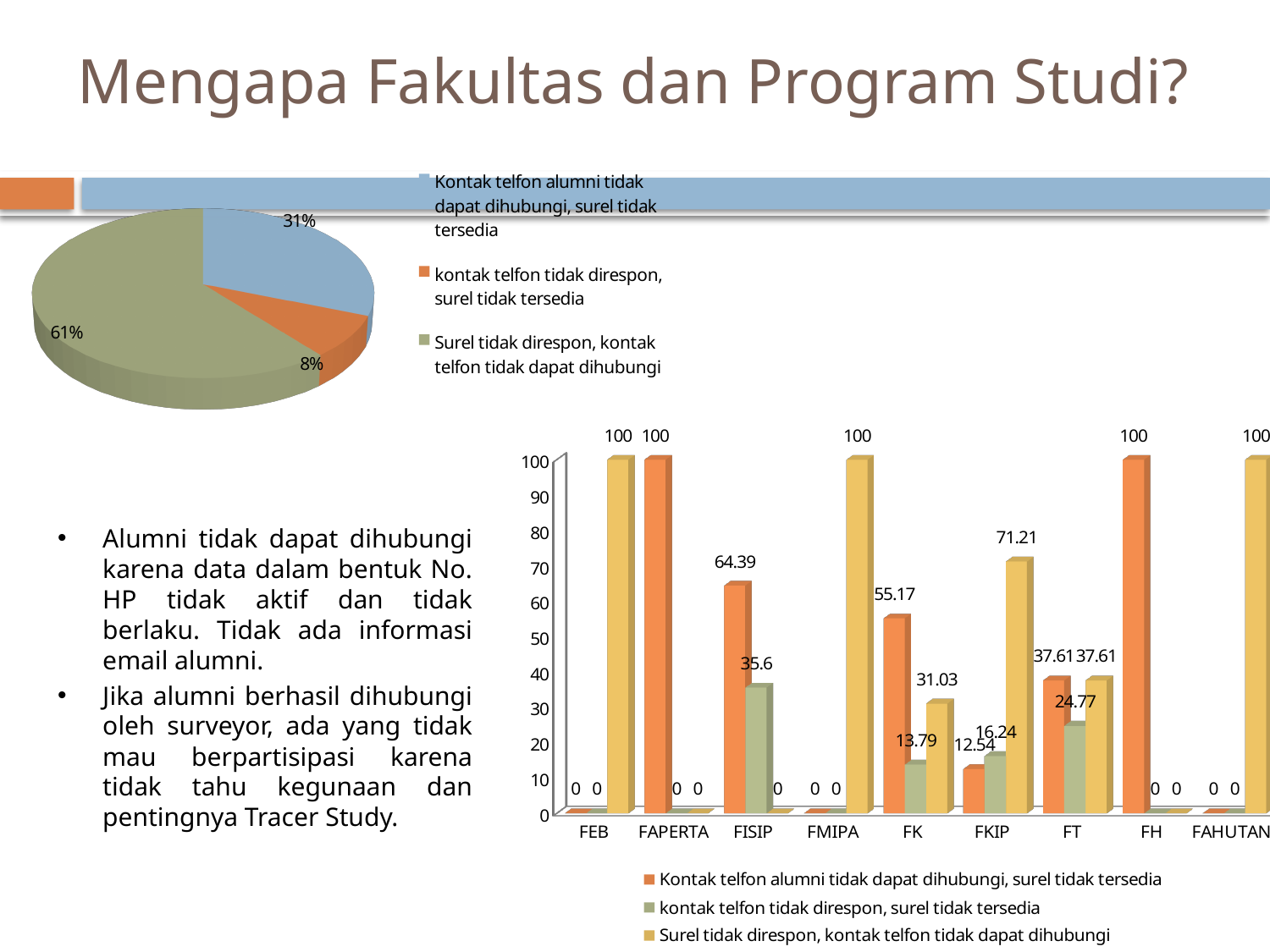
In the pie chart at the top left, which category has the smallest slice? kontak telfon tidak direspon, surel tidak tersedia In the bar chart at the bottom right, which is larger for FK: 'Kontak telfon alumni tidak dapat dihubungi, surel tidak tersedia' or 'Surel tidak direspon, kontak telfon tidak dapat dihubungi'? Kontak telfon alumni tidak dapat dihubungi, surel tidak tersedia In the bar chart at the bottom right, how many series does the legend list? 3 In the pie chart at the top left, what is the share of the 'Kontak telfon alumni tidak dapat dihubungi, surel tidak tersedia' slice? 31% What kind of chart is shown at the top left of the slide? Pie chart In the bar chart at the bottom right, what is the value of 'Kontak telfon alumni tidak dapat dihubungi, surel tidak tersedia' for FISIP? 64.39 In the bar chart at the bottom right, what is the value of 'kontak telfon tidak direspon, surel tidak tersedia' for FKIP? 16.24 In the pie chart at the top left, what share does the slice for 'Surel tidak direspon, kontak telfon tidak dapat dihubungi' have? 61% In the bar chart at the bottom right, what is the value of 'Surel tidak direspon, kontak telfon tidak dapat dihubungi' for FKIP? 71.21 In the bar chart at the bottom right, what is the difference between the 'Kontak telfon alumni tidak dapat dihubungi, surel tidak tersedia' value and the 'kontak telfon tidak direspon, surel tidak tersedia' value for FT? 12.84 In the bar chart at the bottom right, what is the value of 'kontak telfon tidak direspon, surel tidak tersedia' for FK? 13.79 In the bar chart at the bottom right, how many faculty categories are shown on the x axis? 9